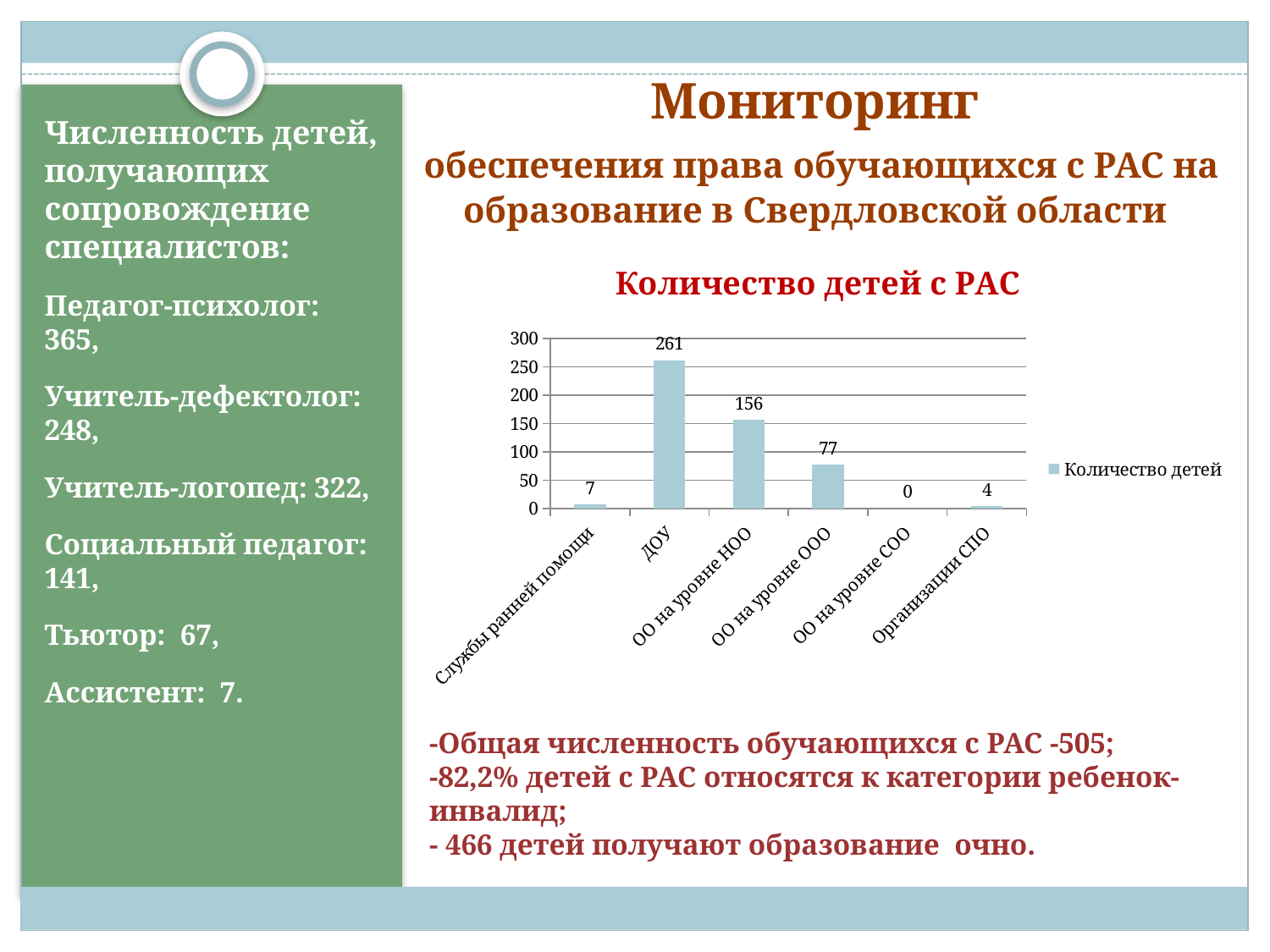
What is the title of the chart? Количество детей с РАС Which category has the lowest value? ОО на уровне СОО What is the value for ОО на уровне НОО? 156 Which category has the highest value? ДОУ What kind of chart is shown? bar chart Which is larger, the value for ОО на уровне ООО or the value for Службы ранней помощи? ОО на уровне ООО Is the value for ОО на уровне ООО greater or less than 100? less How many categories are shown on the x axis? 6 What is the value for Организации СПО? 4 What is the difference between the values for ДОУ and ОО на уровне НОО? 105 What is the value for Службы ранней помощи? 7 What is the value for ДОУ in the chart? 261